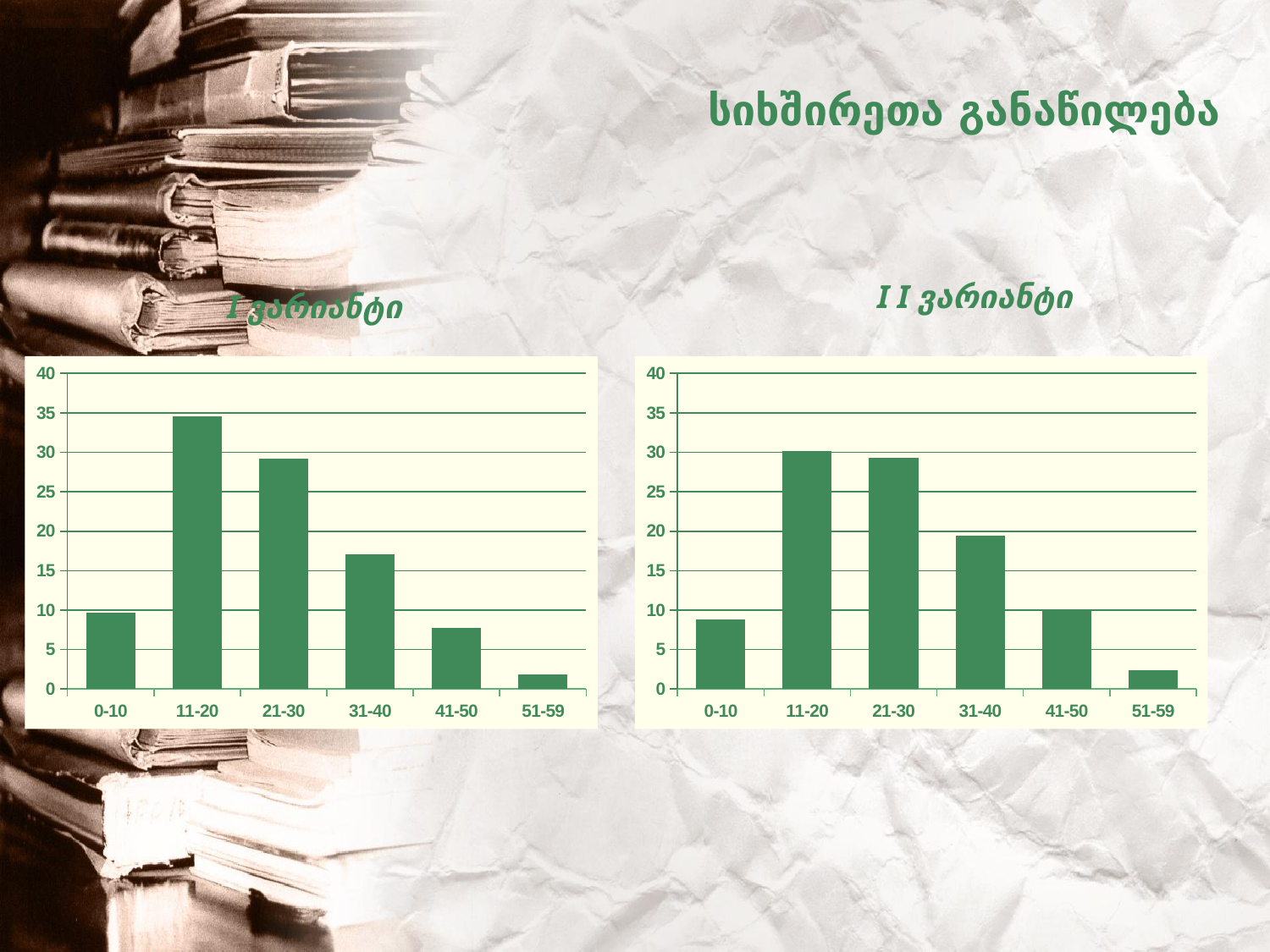
In the left chart (I ვარიანტი), which is larger, the value for 21-30 or the value for 31-40? 21-30 In the right chart (I I ვარიანტი), do the values rise or fall from 21-30 to 51-59? fall In the right chart (I I ვარიანტი), is the value for 0-10 greater or less than 10? less In the left chart (I ვარიანტი), which category has the lowest bar? 51-59 In the left chart (I ვარიანტი), is the value for 11-20 greater or less than 30? greater What kind of chart is the left chart (I ვარიანტი)? bar chart How many categories are shown on the x axis of the right chart (I I ვარიანტი)? 6 In the left chart (I ვარიანტი), is the value for 41-50 greater or less than 10? less What is the title of the slide above the two charts? სიხშირეთა განაწილება In the right chart (I I ვარიანტი), which category has the lowest bar? 51-59 In the left chart (I ვარიანტი), which category has the highest bar? 11-20